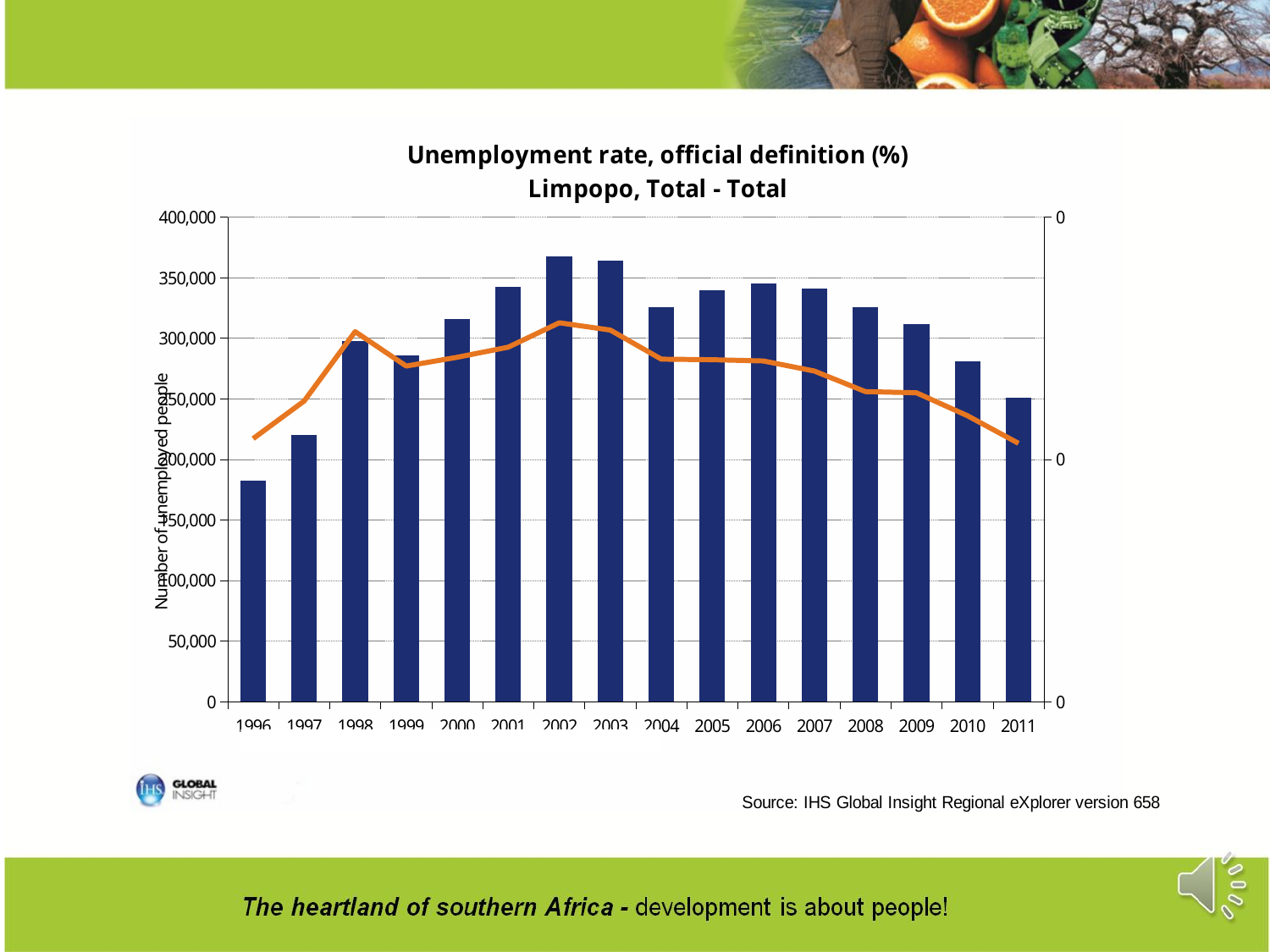
Is the bar value for 2002 greater or less than 350,000? greater Is the bar value for 2010 greater or less than 250,000? greater Is the bar value for 2000 greater or less than 300,000? greater Do the bars rise or fall from 1996 to 2002? rise What is the title of the chart? Unemployment rate, official definition (%) Limpopo, Total - Total What is the label on the left vertical axis? Number of unemployed people Which year has the larger bar, 1997 or 2010? 2010 Which year has the tallest bar in the chart? 2002 Which year has the shortest bar in the chart? 1996 What kind of chart is shown on the slide? A bar chart combined with a line How many years are shown on the x axis of the chart? 16